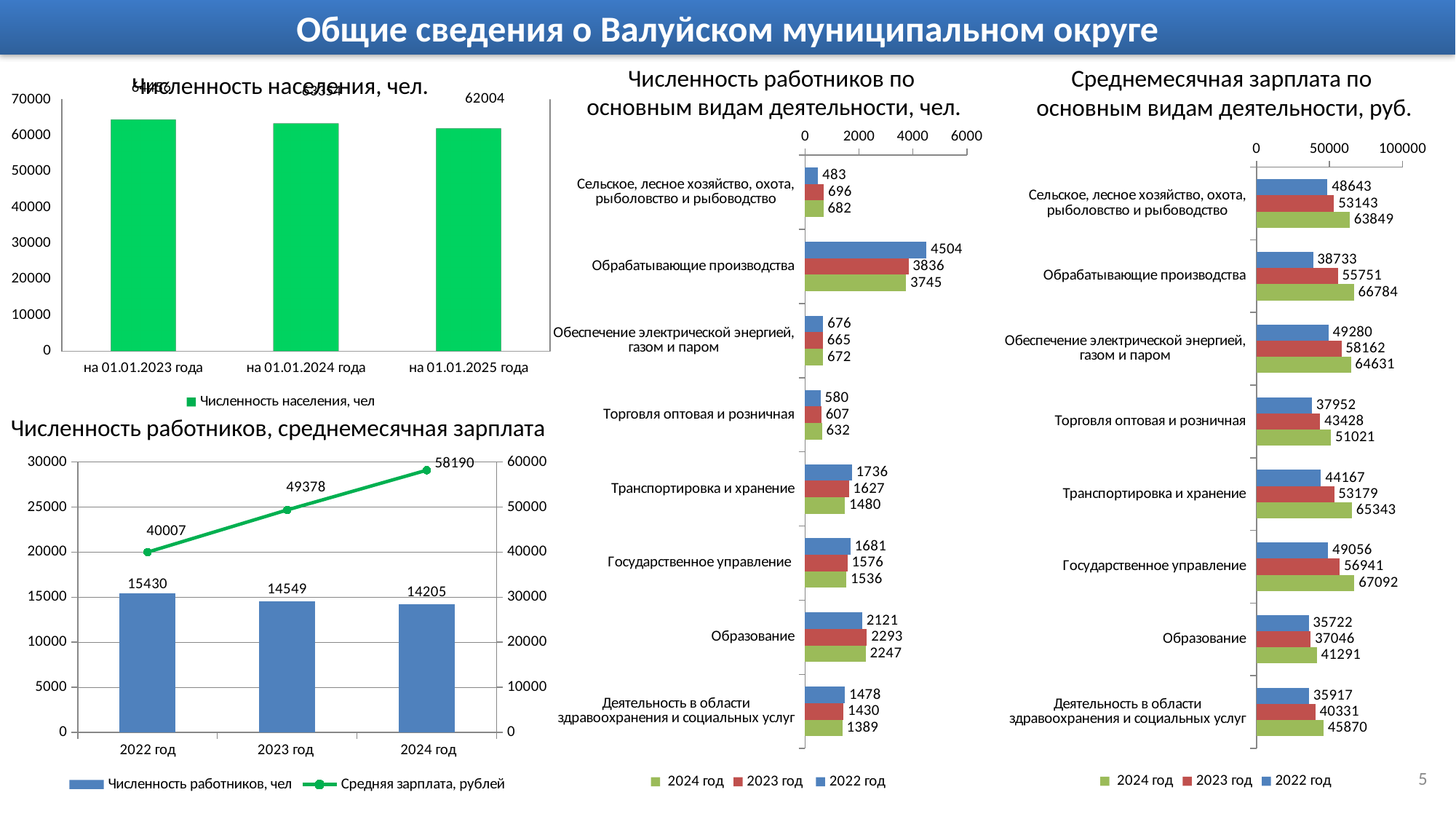
On the chart 'Численность работников, среднемесячная зарплата', what is the difference in number of workers between 2022 год and 2024 год? 1225 On the chart 'Среднемесячная зарплата по основным видам деятельности, руб.', which category has the lowest salary in 2022 год? Образование On the chart 'Численность населения, чел.', how many bars are plotted? 3 On the chart 'Среднемесячная зарплата по основным видам деятельности, руб.', what is the value for 'Государственное управление' in 2024 год? 67092 On the chart 'Численность работников, среднемесячная зарплата', does the average salary line rise or fall from 2022 год to 2024 год? rise On the chart 'Среднемесячная зарплата по основным видам деятельности, руб.', which is larger in 2023 год: 'Торговля оптовая и розничная' or 'Транспортировка и хранение'? Транспортировка и хранение On the chart 'Численность работников по основным видам деятельности, чел.', what is the value for 'Обрабатывающие производства' in 2022 год? 4504 On the chart 'Численность работников, среднемесячная зарплата', what is the number of workers (Численность работников, чел) for 2022 год? 15430 On the chart 'Численность работников, среднемесячная зарплата', what is the average salary (Средняя зарплата, рублей) for 2024 год? 58190 On the chart 'Численность населения, чел.', what is the population value for 'на 01.01.2025 года'? 62004 On the chart 'Численность работников по основным видам деятельности, чел.', which category has the highest number of workers in 2024 год? Обрабатывающие производства On the chart 'Численность работников по основным видам деятельности, чел.', how many series does the legend list? 3